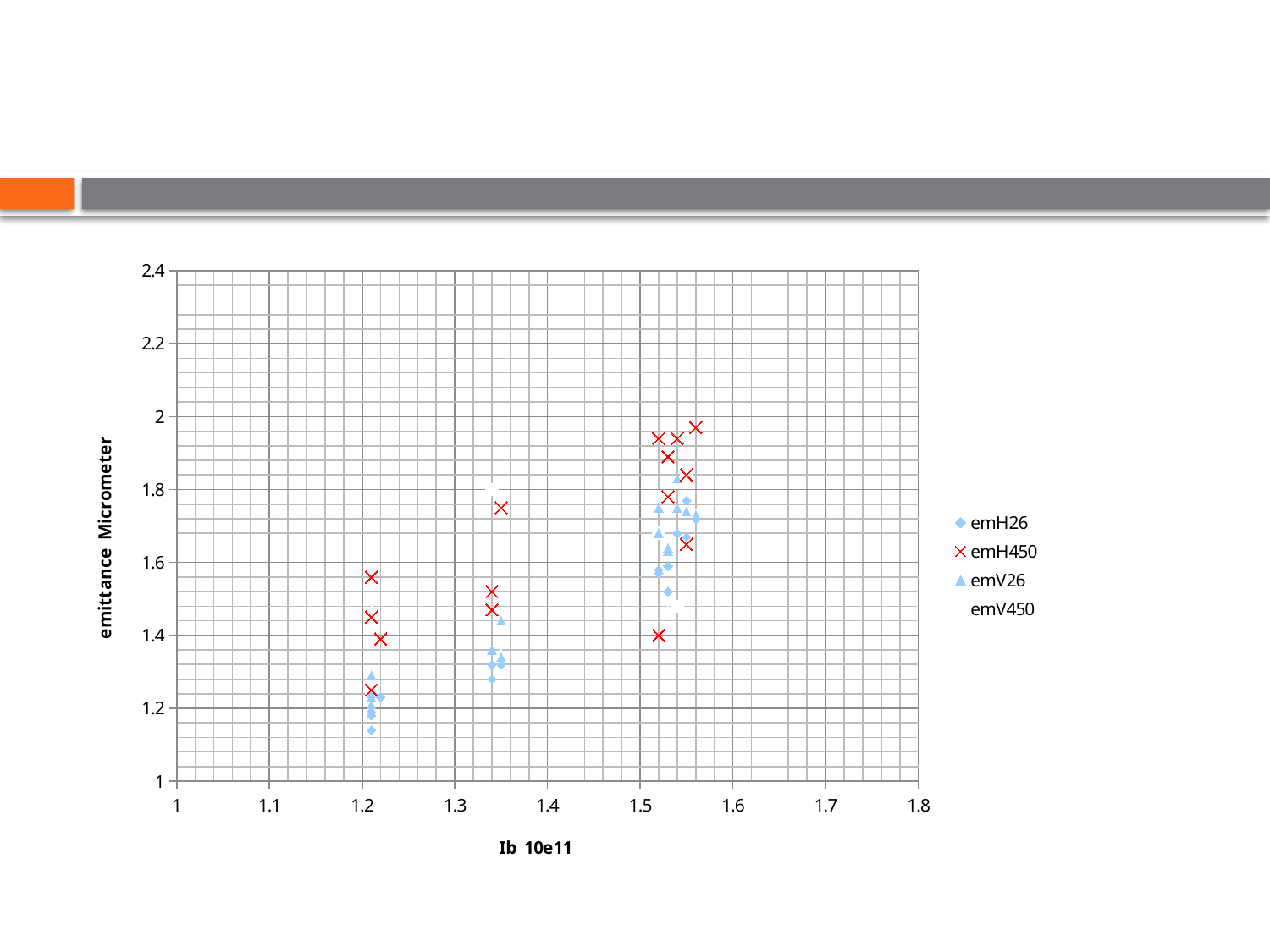
What are the series names listed in the legend? emH26, emH450, emV26, emV450 Is the lowest emH450 value greater or less than 1.4? less What is the title of the vertical axis? emittance Micrometer Which series has the highest plotted emittance values? emH450 Are the emH450 points near Ib = 1.55 higher or lower than the emH450 points near Ib = 1.21? higher Do the emH450 values generally rise or fall as Ib increases along the x axis? rise Is the highest emH450 value greater or less than 2? less What kind of chart is shown on the slide? Scatter chart How many series does the legend list? 4 Is the highest emH450 value greater or less than 1.8? greater What is the maximum value shown on the x axis? 1.8